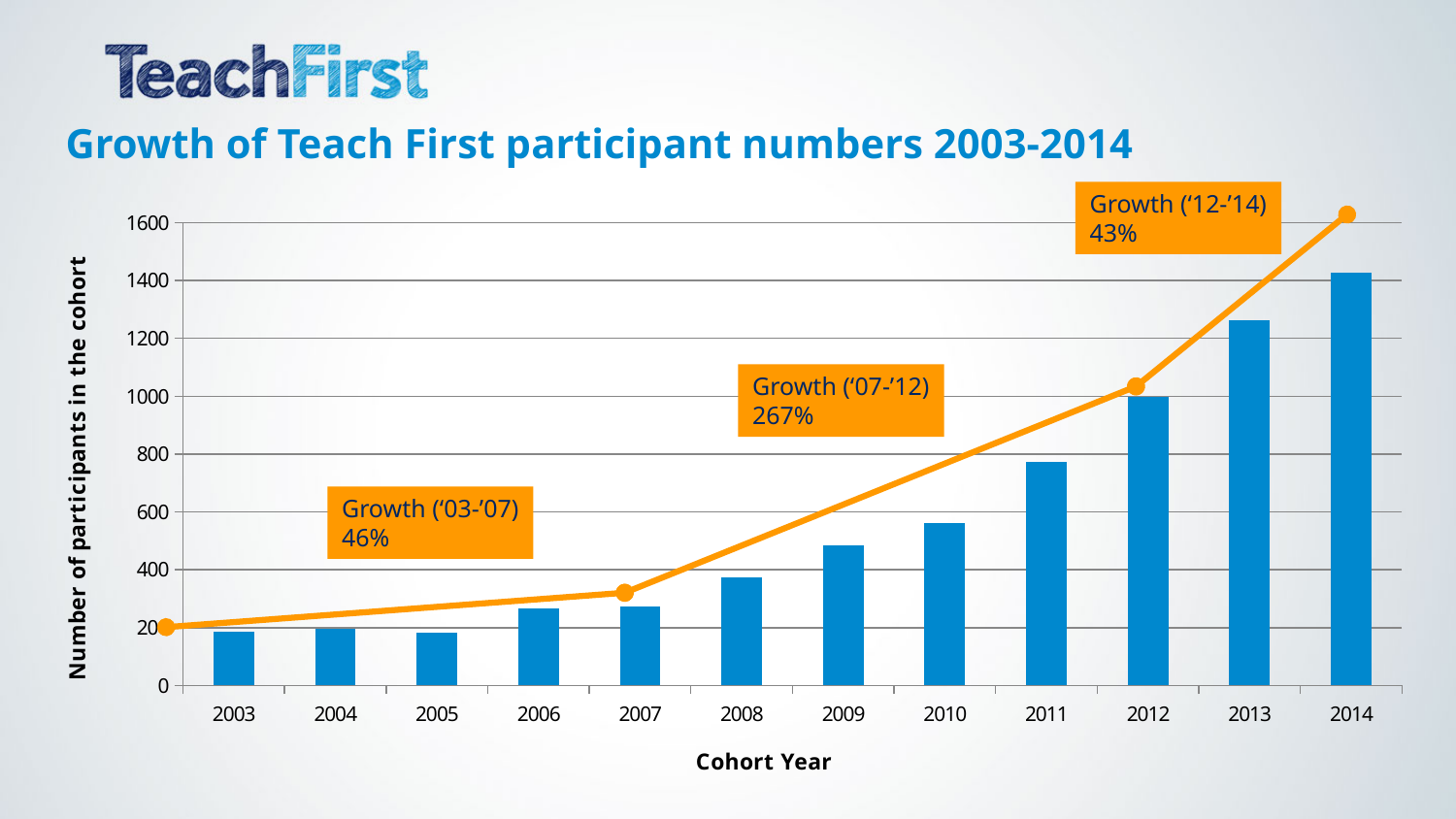
What growth percentage is shown for the period '07-'12? 267% What is the title of the chart? Growth of Teach First participant numbers 2003-2014 Do participant numbers generally rise or fall from 2003 to 2014? rise What growth percentage is shown for the period '12-'14? 43% Is the number of participants for 2008 greater or less than 400? less Which cohort year has more participants, 2011 or 2013? 2013 What growth percentage is shown for the period '03-'07? 46% How many cohort years are shown on the x axis? 12 What kind of chart is shown on the slide? bar chart Is the number of participants for 2011 greater or less than 800? less Which cohort year has the highest number of participants? 2014 Is the number of participants for 2014 greater or less than 1400? greater